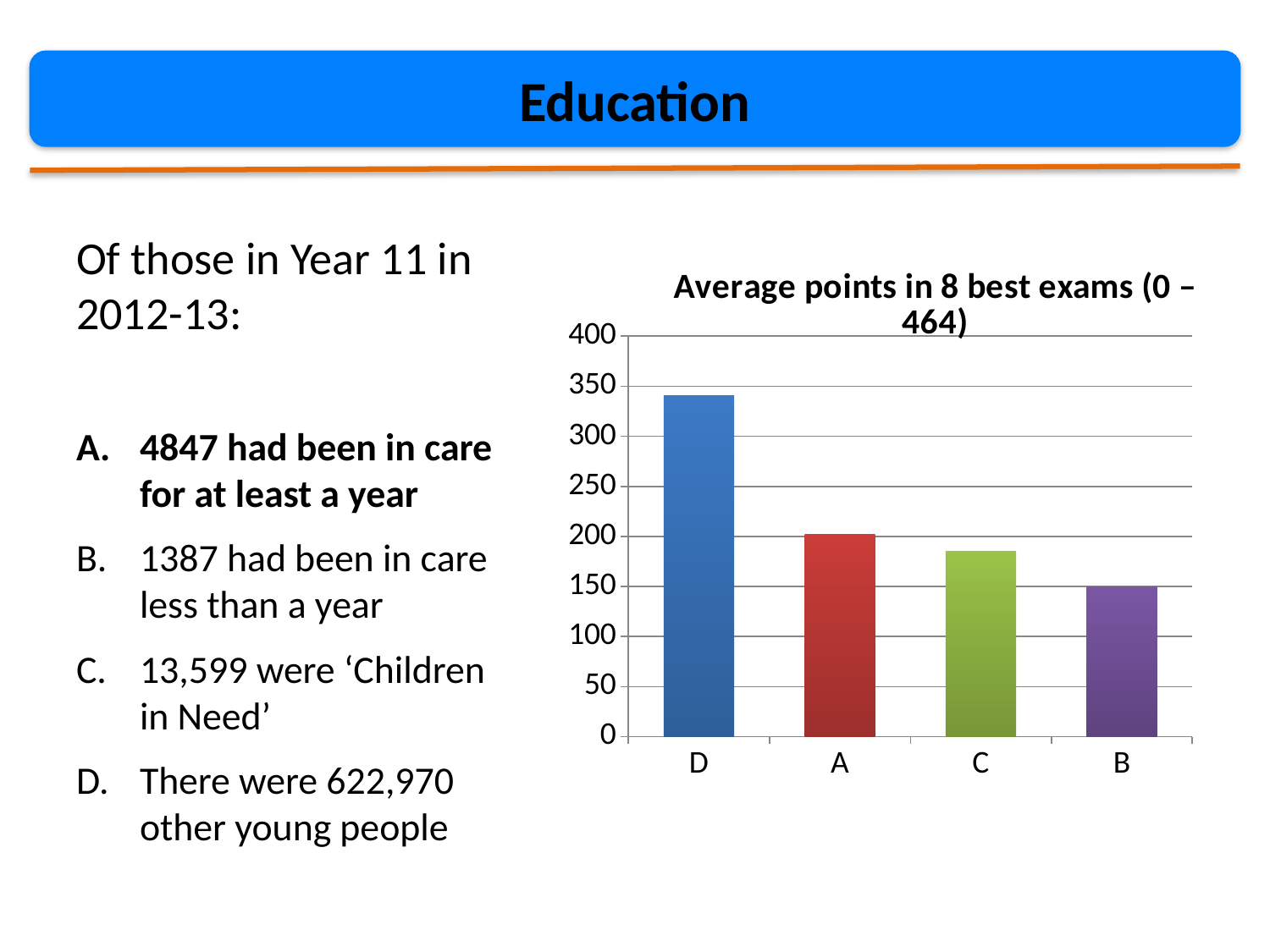
Do the values rise or fall from left to right along the x axis? fall Which category has the lowest average points in the chart? B Is the value for B greater or less than 200? less Is the value for D greater or less than 350? less How many categories are shown on the x axis of the chart? 4 What kind of chart is shown on the slide? bar chart Is the value for D greater or less than 300? greater Which has a higher value in the chart, D or A? D Which category has the highest average points in the chart? D Which has a higher value in the chart, A or B? A What is the title of the chart? Average points in 8 best exams (0 – 464)